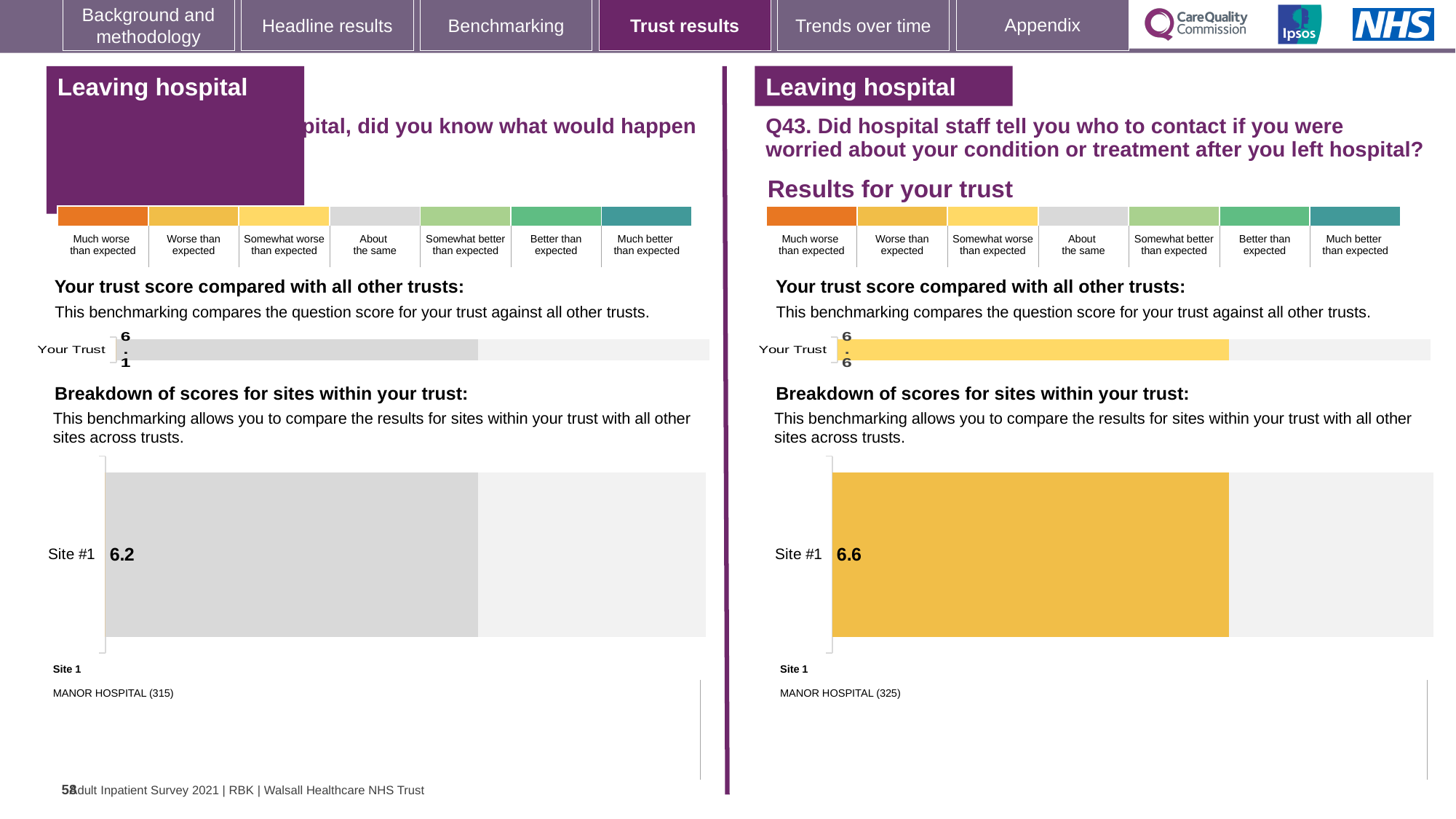
What colour is the Site #1 bar in the right-hand 'Breakdown of scores for sites within your trust' chart? yellow On the right-hand 'Your trust score compared with all other trusts' chart (Q43), what is the score for Your Trust? 6.6 On the left-hand 'Your trust score compared with all other trusts' chart, what is the score for Your Trust? 6.1 On the left-hand breakdown chart, which site is labelled as Site 1? MANOR HOSPITAL (315) How many sites are shown in the right-hand 'Breakdown of scores for sites within your trust' chart? 1 What kind of chart is used to show the Site #1 score on the right-hand side of the slide? bar chart Which benchmark category does the grey colour of the Site #1 bar on the left-hand breakdown chart correspond to? About the same Which is larger: the Site #1 score on the left-hand breakdown chart or the Site #1 score on the right-hand breakdown chart? right-hand (6.6) On the right-hand breakdown chart, which site is labelled as Site 1? MANOR HOSPITAL (325) On the right-hand 'Breakdown of scores for sites within your trust' chart (Q43), what is the score for Site #1? 6.6 On the left-hand 'Breakdown of scores for sites within your trust' chart, what is the score for Site #1? 6.2 What is the difference between the Site #1 score on the right-hand breakdown chart (6.6) and the Site #1 score on the left-hand breakdown chart (6.2)? 0.4